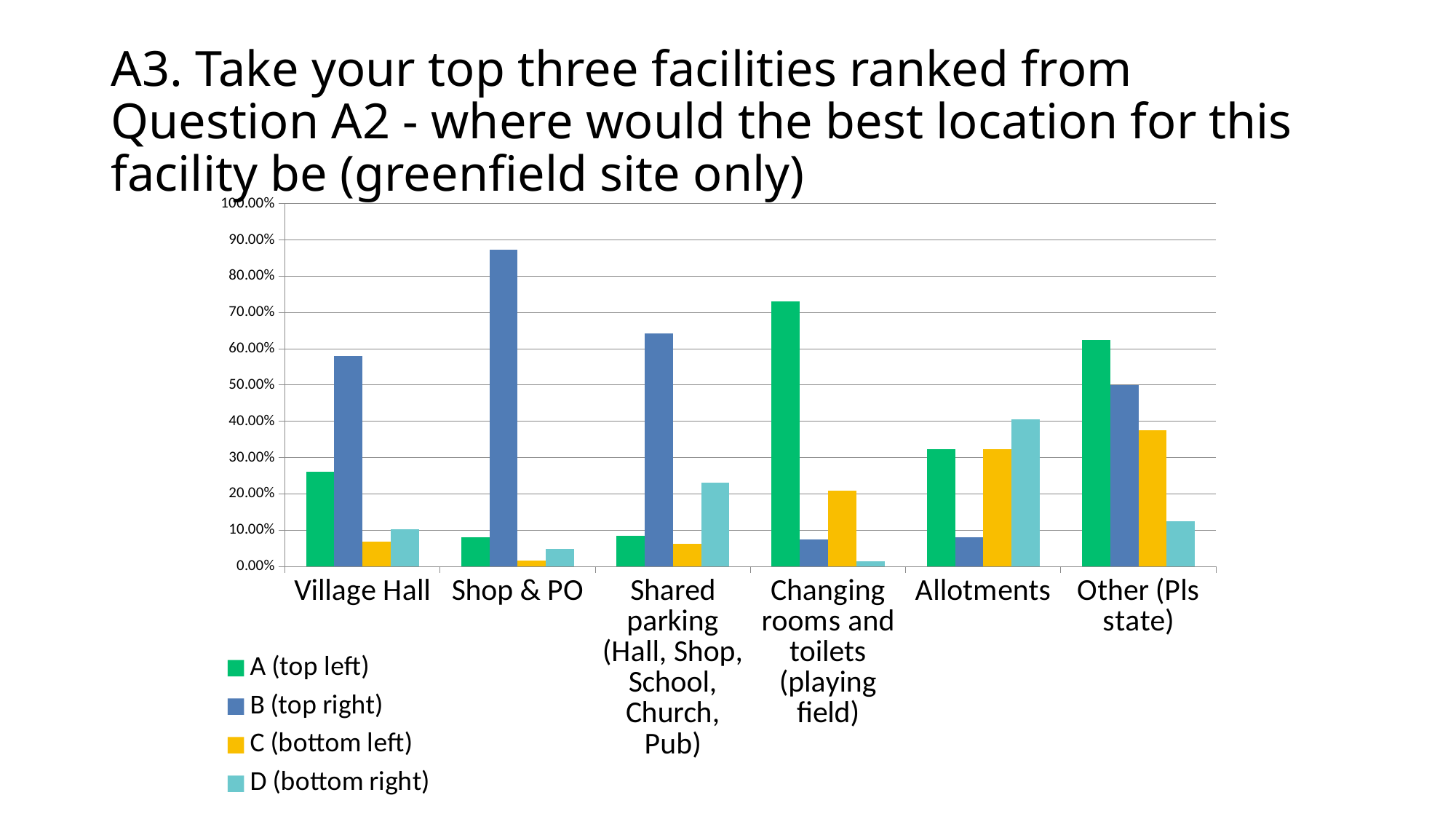
Which category has the highest value for A (top left)? Changing rooms and toilets (playing field) Is the value for D (bottom right) at Allotments greater or less than 30.00%? greater What kind of chart is shown on the slide? bar chart For Village Hall, which is larger: A (top left) or B (top right)? B (top right) How many series does the legend list? 4 How many facility categories are shown on the x axis? 6 Which category has the highest value for B (top right)? Shop & PO Which category has the lowest value for D (bottom right)? Changing rooms and toilets (playing field) For Other (Pls state), which is larger: A (top left) or B (top right)? A (top left) Which series is shown in yellow in the legend? C (bottom left) Is the value for B (top right) at Shop & PO greater or less than 80.00%? greater Is the value for A (top left) at Changing rooms and toilets (playing field) greater or less than 60.00%? greater